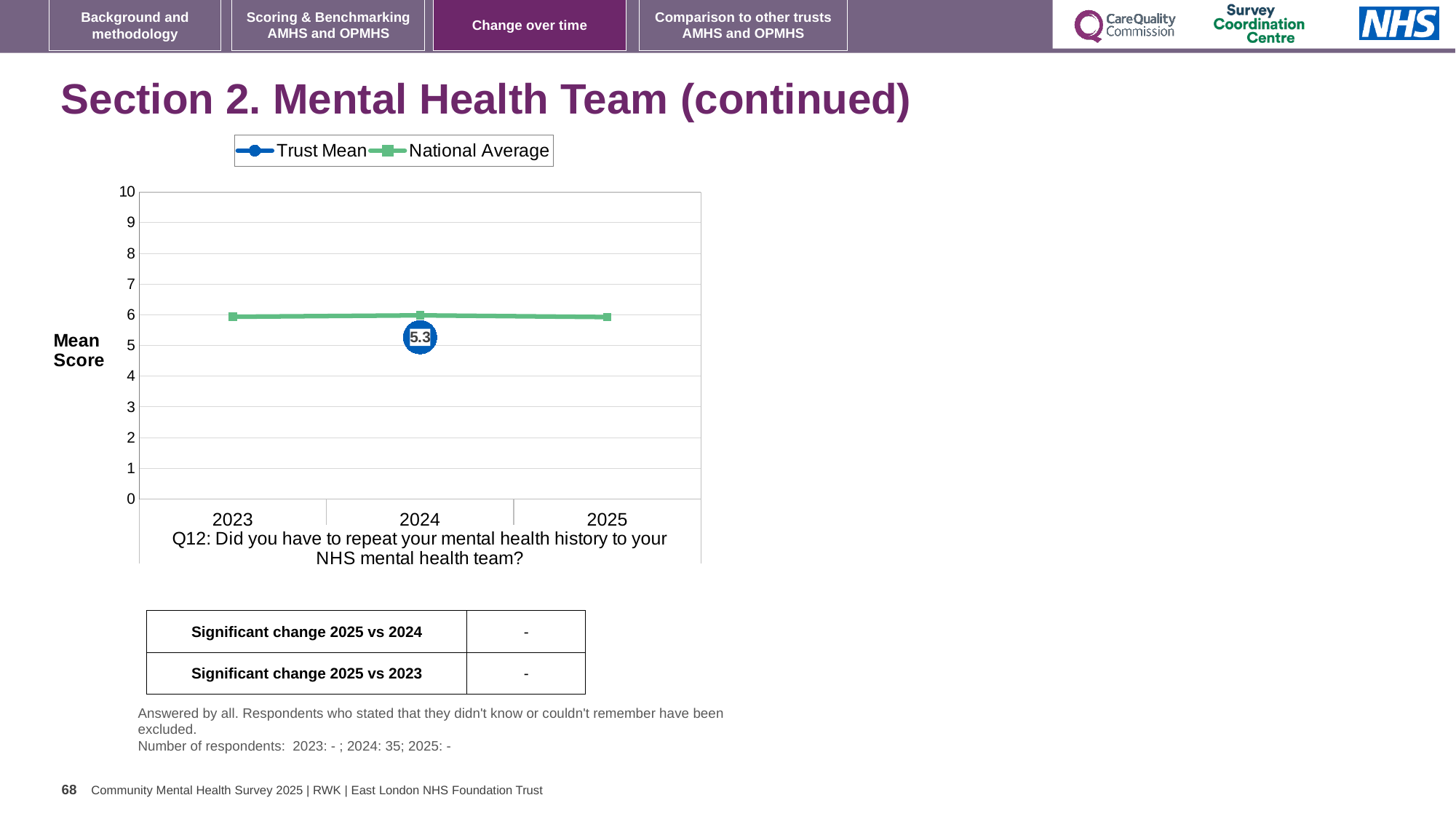
Which year is the only one with a Trust Mean data point plotted? 2024 Is the Trust Mean value for 2024 greater or less than 6? less What kind of chart is shown on the slide? line chart What is the Trust Mean value for 2024? 5.3 In 2024, which is higher: the Trust Mean or the National Average? National Average Which survey question does the chart relate to? Q12: Did you have to repeat your mental health history to your NHS mental health team? How many series does the legend list? 2 Is the National Average value for 2025 greater or less than 7? less How many years are shown on the x axis? 3 Is the National Average value for 2023 greater or less than 5? greater What is the label on the y axis of the chart? Mean Score